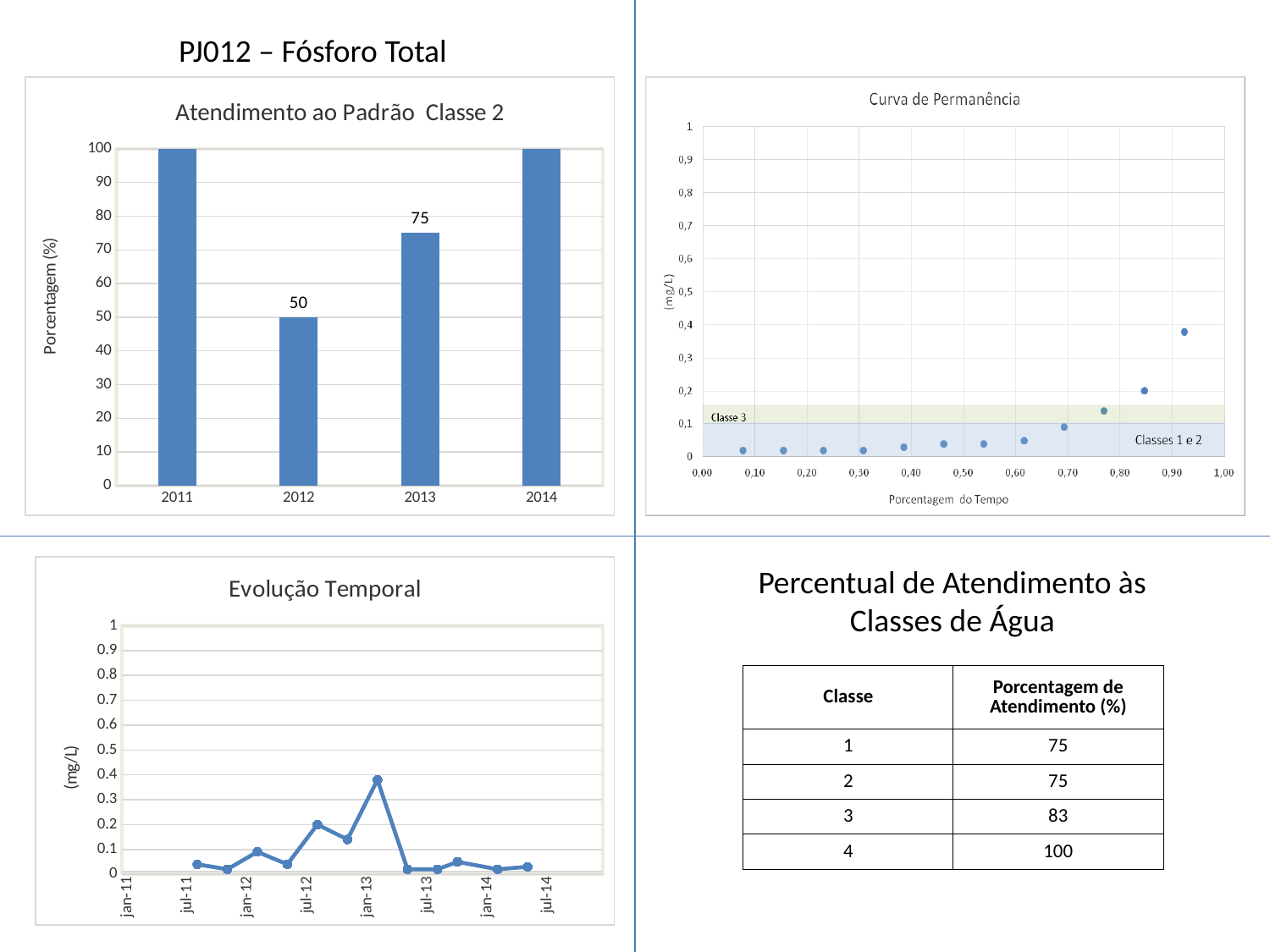
In the 'Curva de Permanência' chart, is the highest plotted value greater or less than 0,3? greater In the 'Atendimento ao Padrão Classe 2' chart, what is the difference between the values for 2013 and 2012? 25 In the 'Evolução Temporal' chart, is the value at jan-13 greater or less than 0.3? greater What kind of chart is 'Atendimento ao Padrão Classe 2'? bar chart In the 'Atendimento ao Padrão Classe 2' chart, which is larger, the value for 2012 or the value for 2013? 2013 In the 'Atendimento ao Padrão Classe 2' chart, which year has the lowest value? 2012 How many years are shown in the 'Atendimento ao Padrão Classe 2' chart? 4 In the 'Curva de Permanência' chart, do the values rise or fall as Porcentagem do Tempo increases? rise What is the y-axis label of the 'Atendimento ao Padrão Classe 2' chart? Porcentagem (%) In the 'Atendimento ao Padrão Classe 2' chart, what is the value for 2013? 75 In the 'Atendimento ao Padrão Classe 2' chart, what is the value for 2011? 100 In the 'Atendimento ao Padrão Classe 2' chart, what is the value for 2012? 50